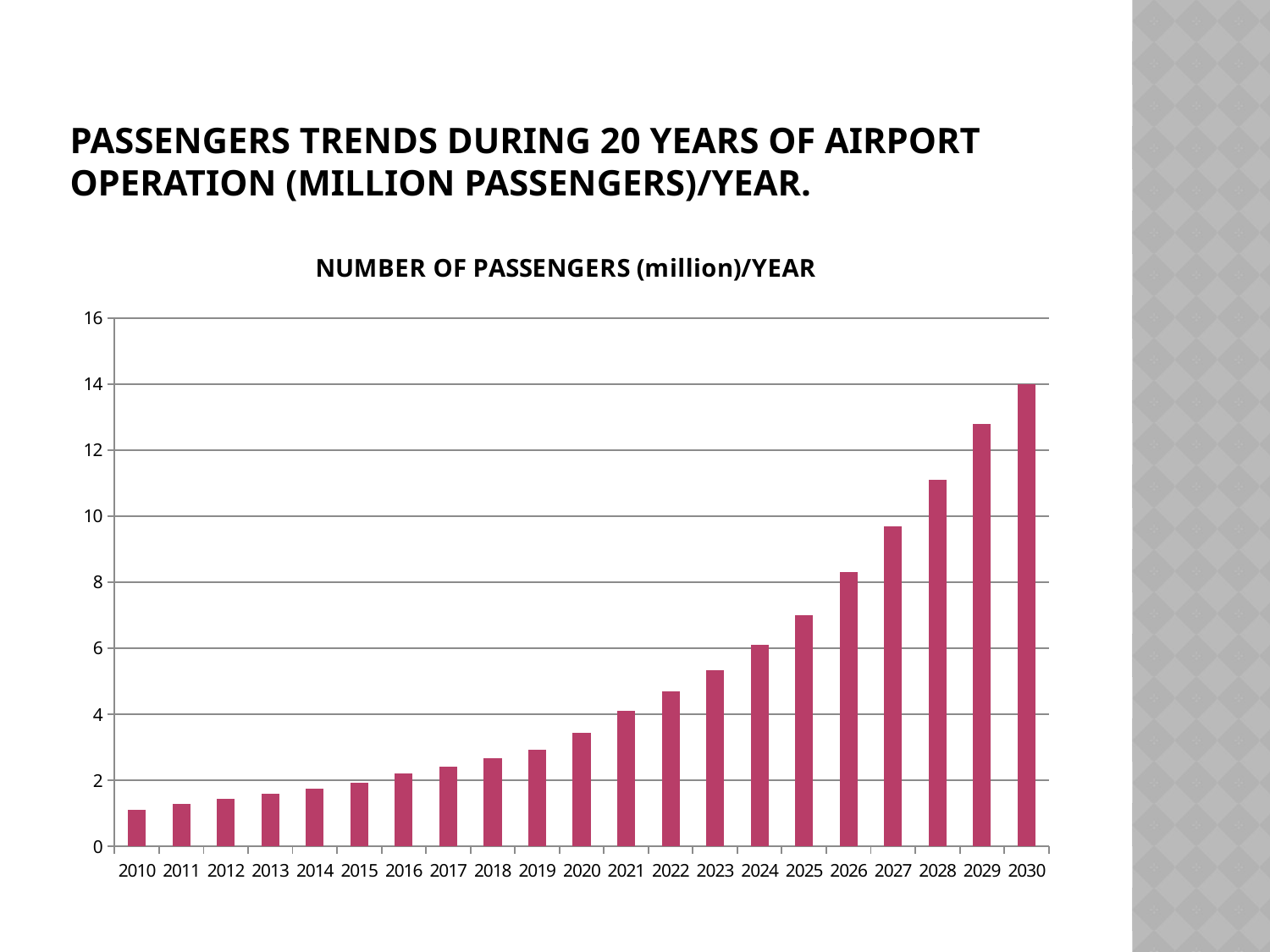
Do the values rise or fall from 2010 to 2030? rise What is the highest value shown on the vertical axis? 16 What is the title of the chart? NUMBER OF PASSENGERS (million)/YEAR How many years are plotted on the x axis? 21 Which year has the lowest number of passengers? 2010 What is the number of passengers (million) for 2030? 14 Which year has the highest number of passengers? 2030 What kind of chart is shown on the slide? bar chart Is the value for 2025 greater or less than 6? greater Which is larger, the value for 2015 or the value for 2022? 2022 Is the value for 2020 greater or less than 4? less Is the value for 2028 greater or less than 10? greater